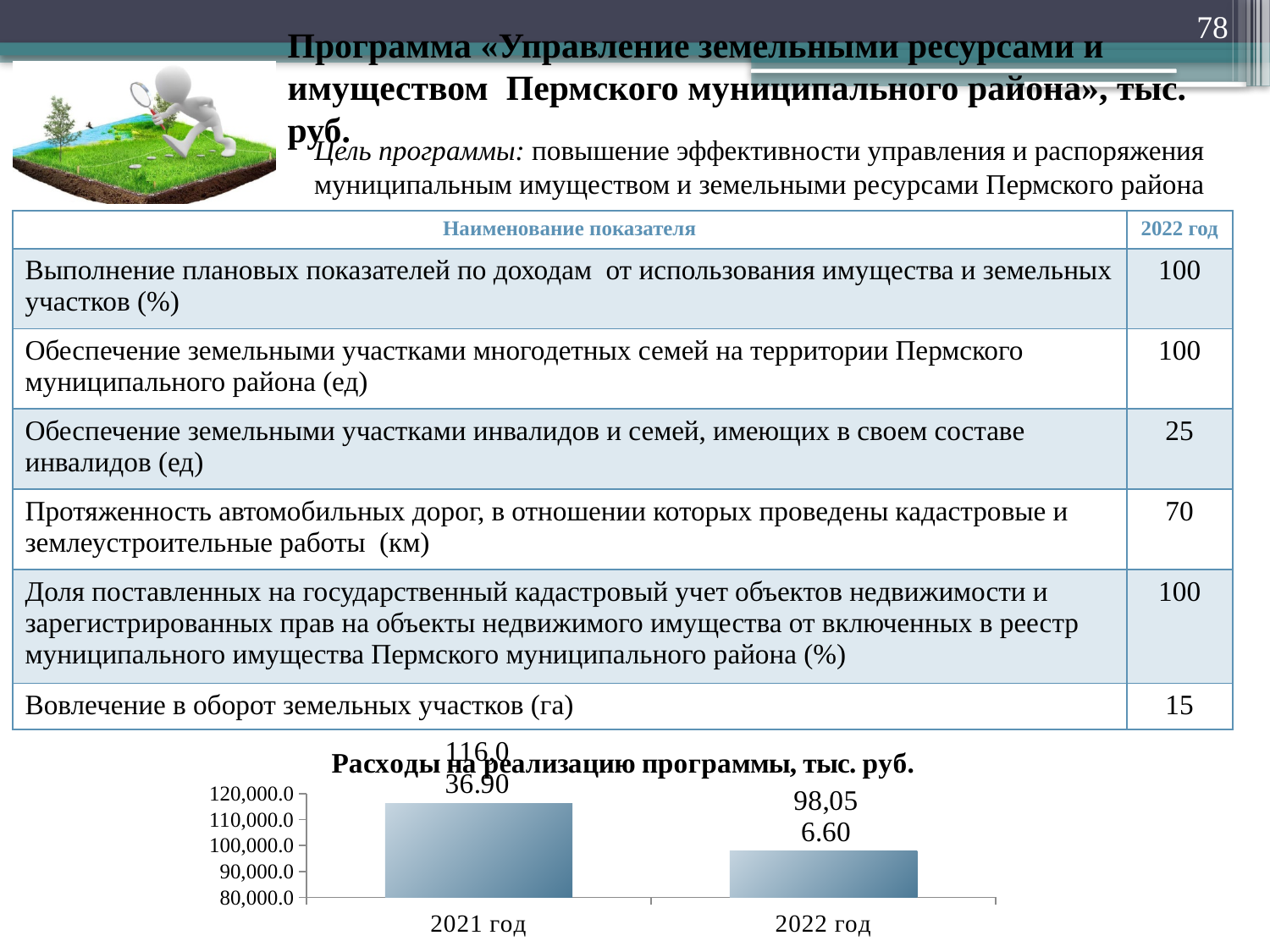
Do the values in the chart 'Расходы на реализацию программы, тыс. руб.' rise or fall from 2021 год to 2022 год? fall In the chart 'Расходы на реализацию программы, тыс. руб.', is the value for 2021 год greater or less than 110,000.0? greater What kind of chart is shown at the bottom of the slide? bar chart In the chart 'Расходы на реализацию программы, тыс. руб.', which year has the lower value? 2022 год What is the lowest value shown on the vertical axis of the chart 'Расходы на реализацию программы, тыс. руб.'? 80,000.0 What is the title of the chart at the bottom of the slide? Расходы на реализацию программы, тыс. руб. In the chart 'Расходы на реализацию программы, тыс. руб.', is the value for 2022 год greater or less than 100,000.0? less In the chart 'Расходы на реализацию программы, тыс. руб.', which year has the higher value? 2021 год In the chart 'Расходы на реализацию программы, тыс. руб.', is the value for 2022 год greater or less than 90,000.0? greater In the chart 'Расходы на реализацию программы, тыс. руб.', is the value for 2021 год larger or smaller than the value for 2022 год? larger How many categories (years) are plotted in the chart 'Расходы на реализацию программы, тыс. руб.'? 2